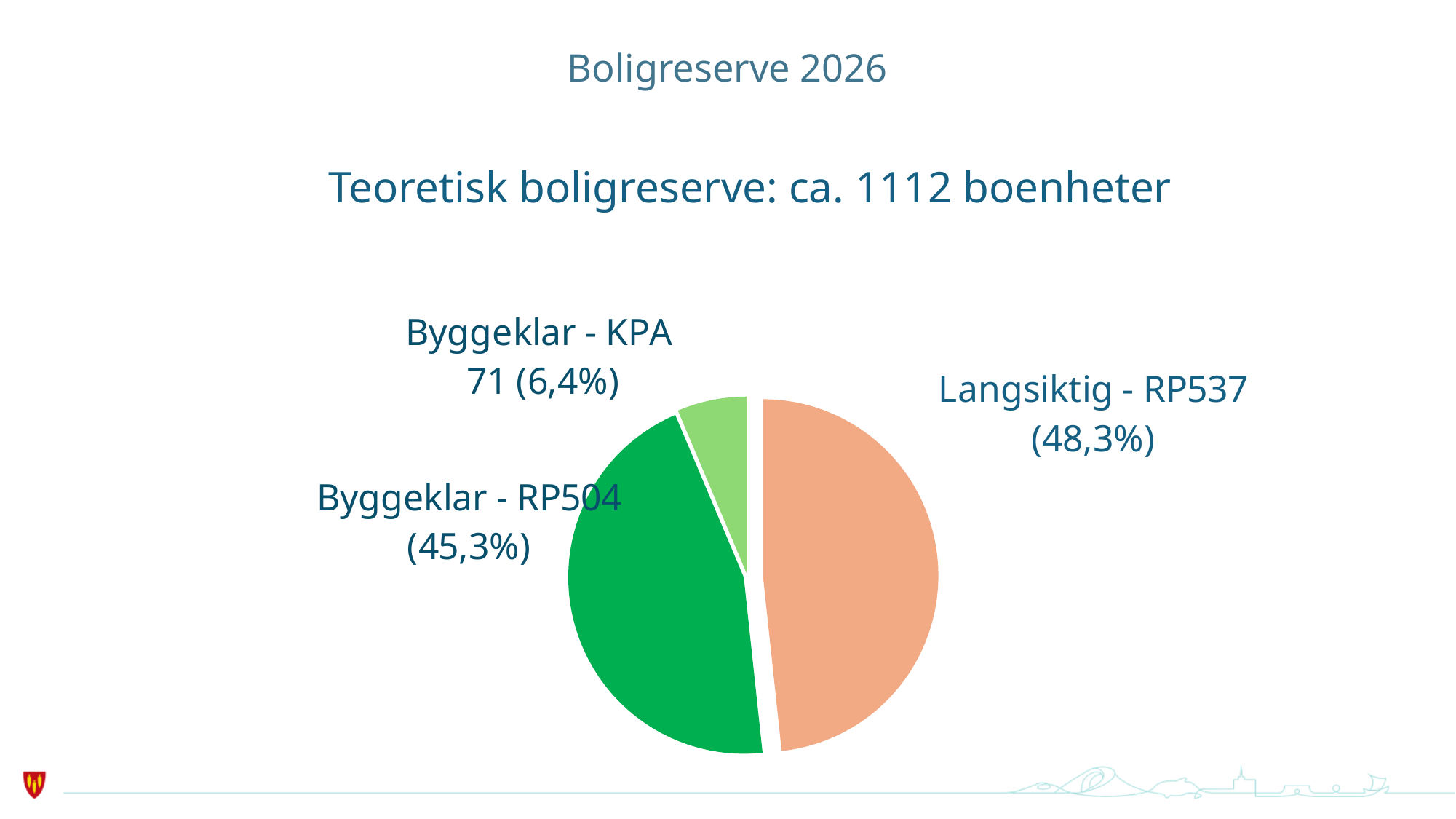
What share of the pie does the Langsiktig - RP slice represent? 48,3% How many slices does the pie chart have? 3 What kind of chart is shown on the slide? pie chart What value is printed for the Byggeklar - KPA slice? 71 What is the title of the slide? Boligreserve 2026 Which slice of the pie is the smallest? Byggeklar - KPA Which is larger, the Langsiktig - RP slice or the Byggeklar - RP slice? Langsiktig - RP What share of the pie does the Byggeklar - KPA slice represent? 6,4% What is the difference in percentage share between the Langsiktig - RP slice (48,3%) and the Byggeklar - RP slice (45,3%)? 3,0% According to the slide, what is the theoretical housing reserve (teoretisk boligreserve)? ca. 1112 boenheter Which slice of the pie is the largest? Langsiktig - RP What share of the pie does the Byggeklar - RP slice represent? 45,3%